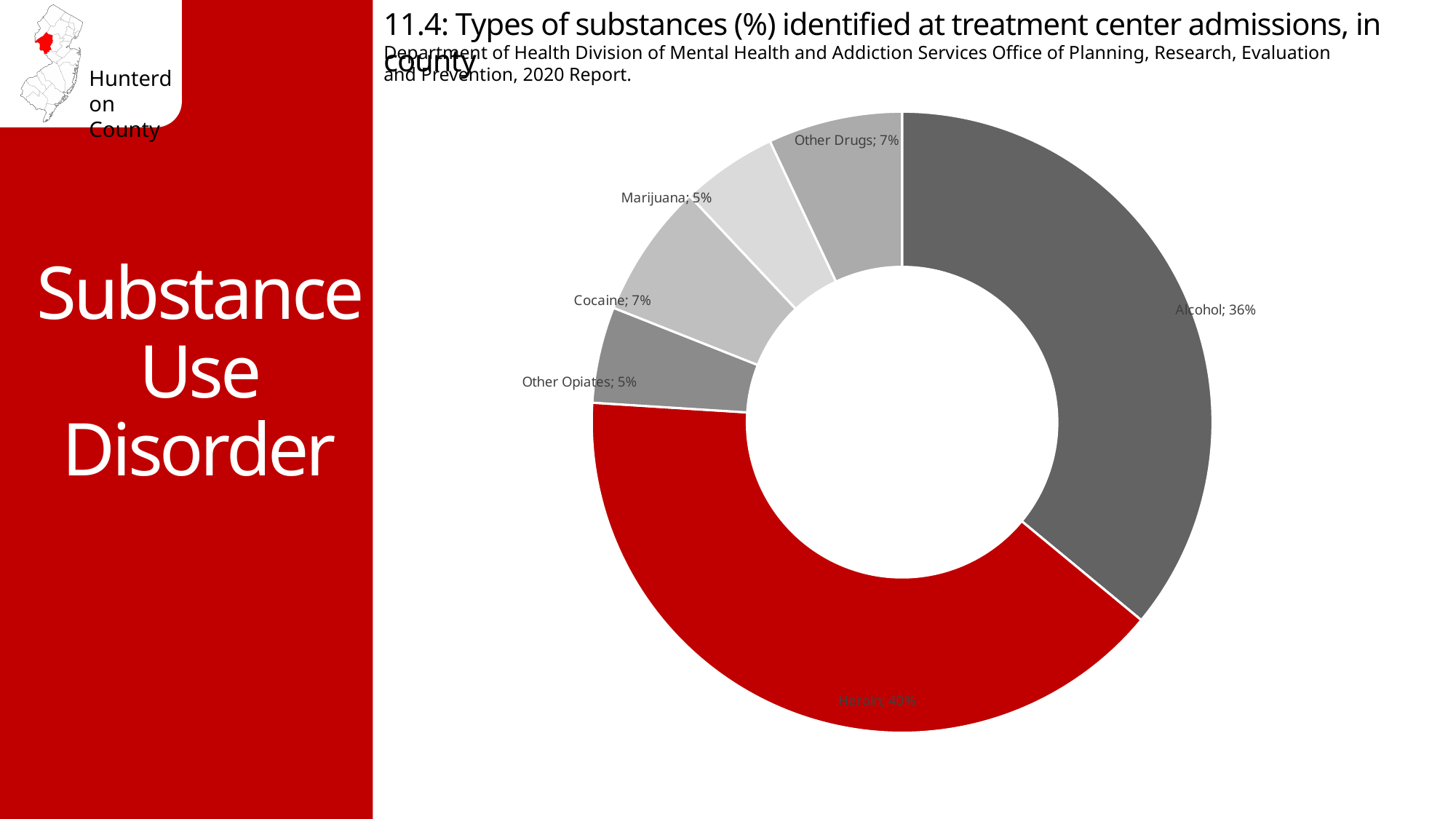
Which slice of the chart is coloured red? Heroin What kind of chart is shown on the slide? Doughnut (pie) chart What percentage of treatment center admissions identified Heroin? 40% What percentage is shown for Other Opiates? 5% How many substance categories are shown in the chart? 6 What percentage of treatment center admissions identified Alcohol? 36% What is the combined percentage for Heroin and Alcohol? 76% Which is larger, the share for Cocaine or the share for Marijuana? Cocaine What percentage is shown for Cocaine? 7% Which substance has the largest share of admissions? Heroin What is the difference in percentage points between Heroin and Alcohol? 4 What percentage is shown for Marijuana? 5%